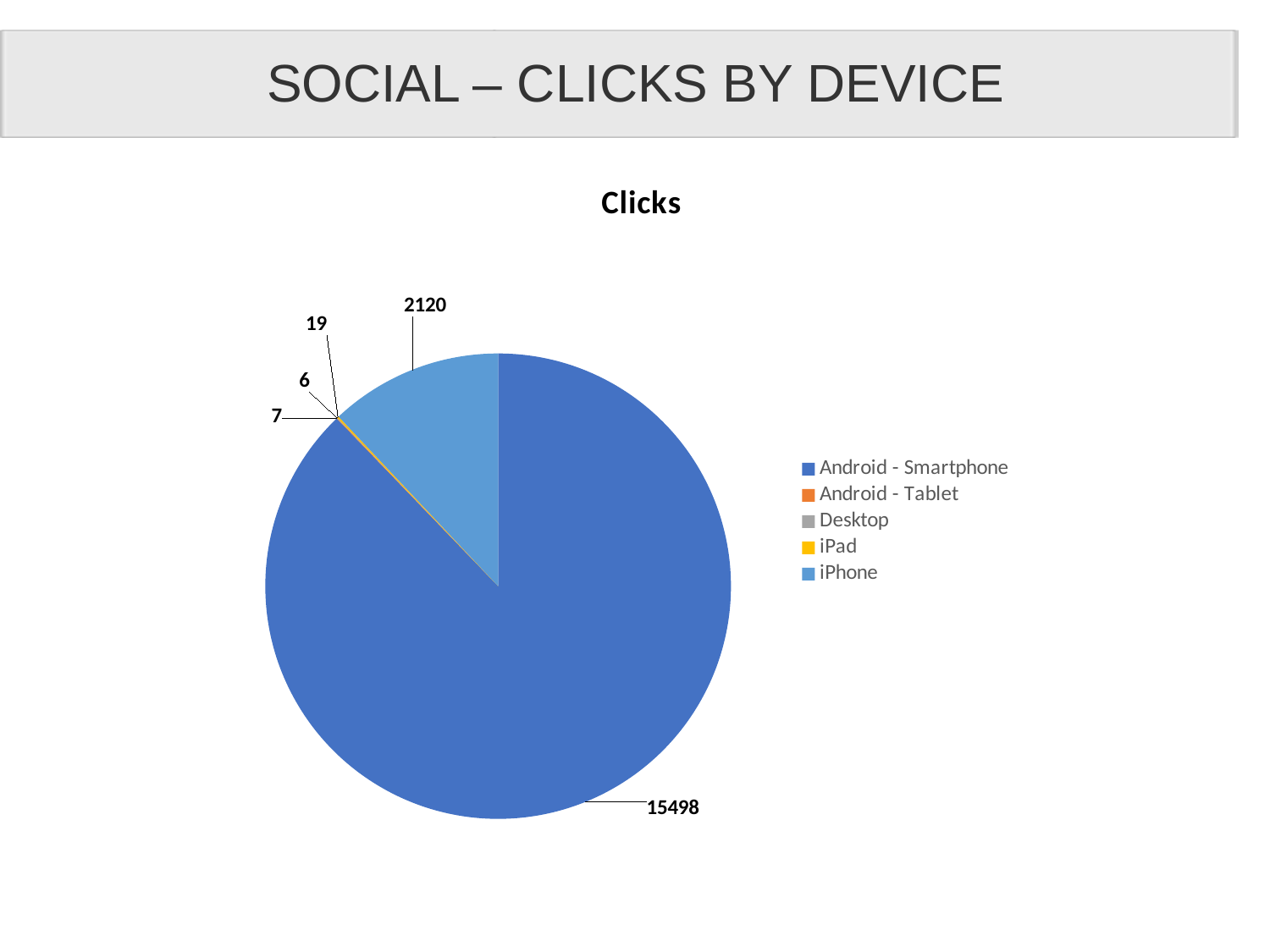
Which colour represents iPad in the legend? yellow Which has more clicks, iPhone or Android - Smartphone? Android - Smartphone What is the total number of clicks across all slices of the pie? 17650 How many clicks are shown for iPhone? 2120 How many clicks are shown for Android - Smartphone? 15498 What kind of chart is shown on the slide? pie chart What is the title of the chart? Clicks What is the difference in clicks between Android - Smartphone and iPhone? 13378 What is the smallest value labelled on the pie chart? 6 Which device category has the most clicks? Android - Smartphone How many device categories does the legend list? 5